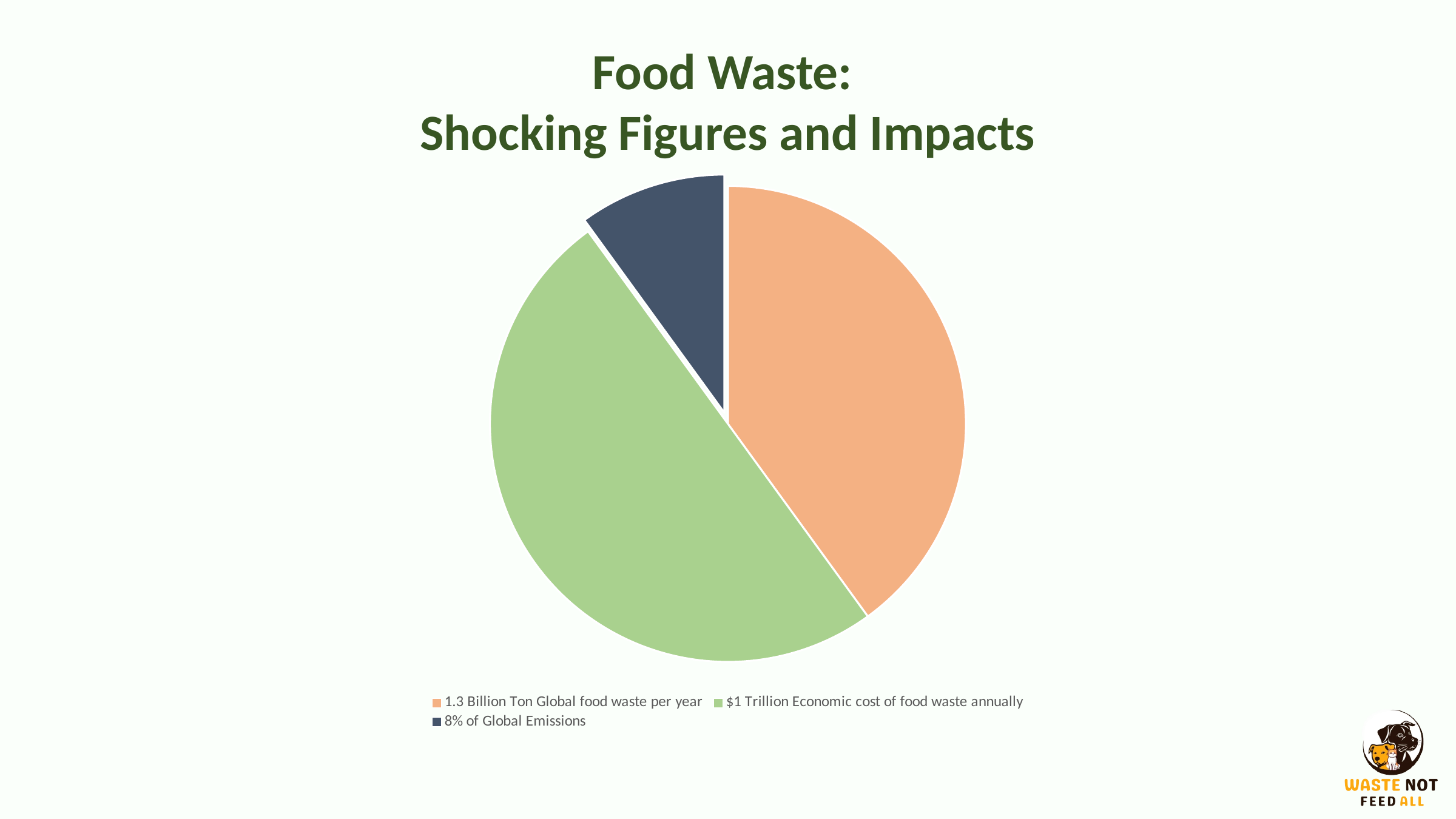
Which legend category has the largest slice of the pie chart? $1 Trillion Economic cost of food waste annually Which slice is larger: '$1 Trillion Economic cost of food waste annually' or '1.3 Billion Ton Global food waste per year'? $1 Trillion Economic cost of food waste annually Which slice is larger: '1.3 Billion Ton Global food waste per year' or '8% of Global Emissions'? 1.3 Billion Ton Global food waste per year How many entries does the legend of the pie chart list? 3 Which legend category has the smallest slice of the pie chart? 8% of Global Emissions What is the title of the slide containing the pie chart? Food Waste: Shocking Figures and Impacts What colour is the slice for '8% of Global Emissions' in the pie chart? Dark blue How many slices does the pie chart have? 3 What kind of chart is shown on the slide? Pie chart